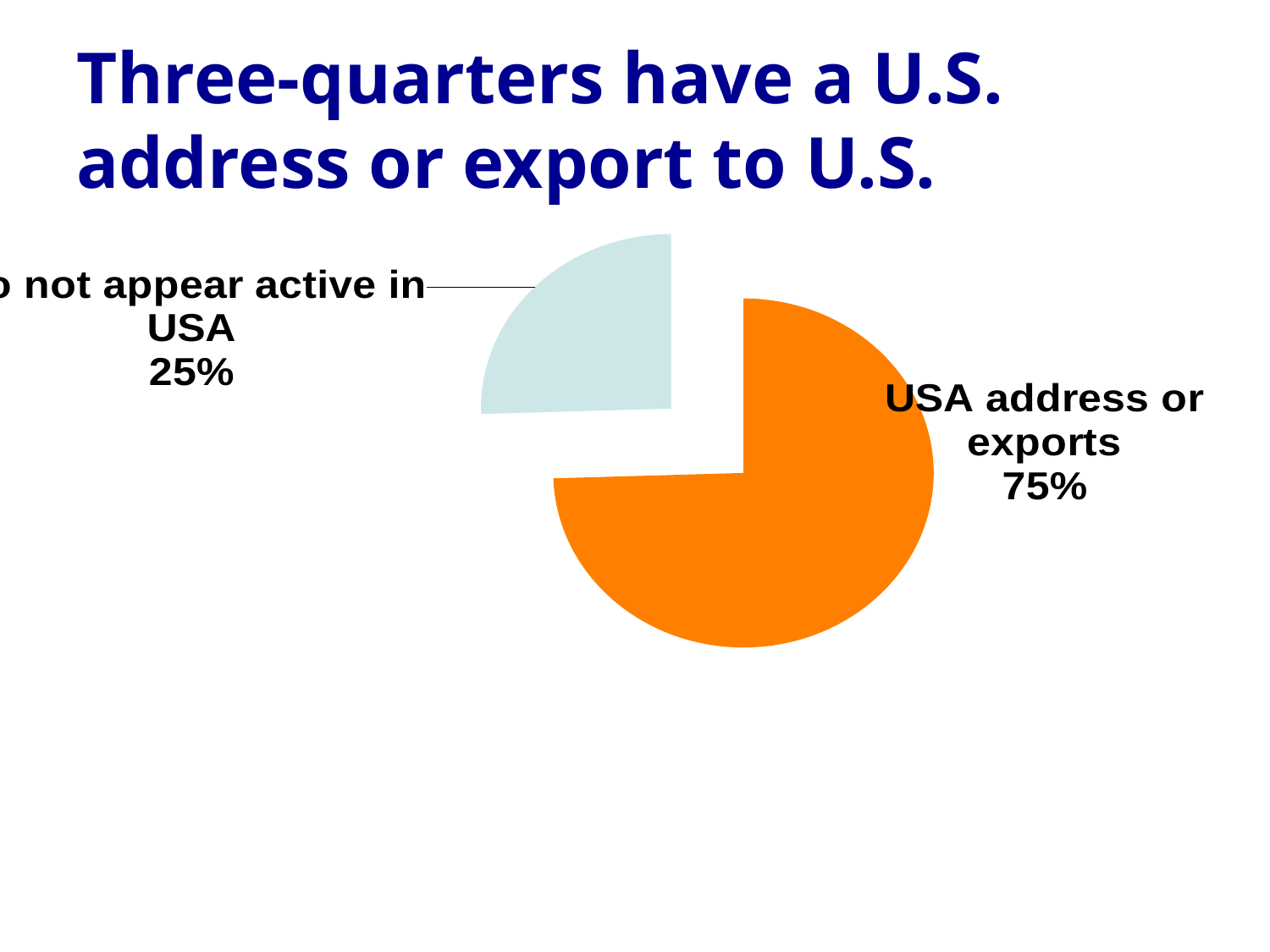
What do the two slices of the pie add up to? 100% Which slice of the pie is the largest? USA address or exports How many slices does the pie chart have? 2 Which slice of the pie is the smallest? the light blue slice (not appear active in USA) Is the share for "USA address or exports" greater or less than 50%? greater What percentage is shown for the light blue slice of the pie? 25% What kind of chart is shown on the slide? pie chart What colour is the "USA address or exports" slice? orange What is the difference in percentage points between the "USA address or exports" slice and the light blue slice? 50 percentage points What share of the pie is labelled "USA address or exports"? 75% Which is larger: the "USA address or exports" slice or the light blue slice? USA address or exports What is the title of the slide containing the pie chart? Three-quarters have a U.S. address or export to U.S.